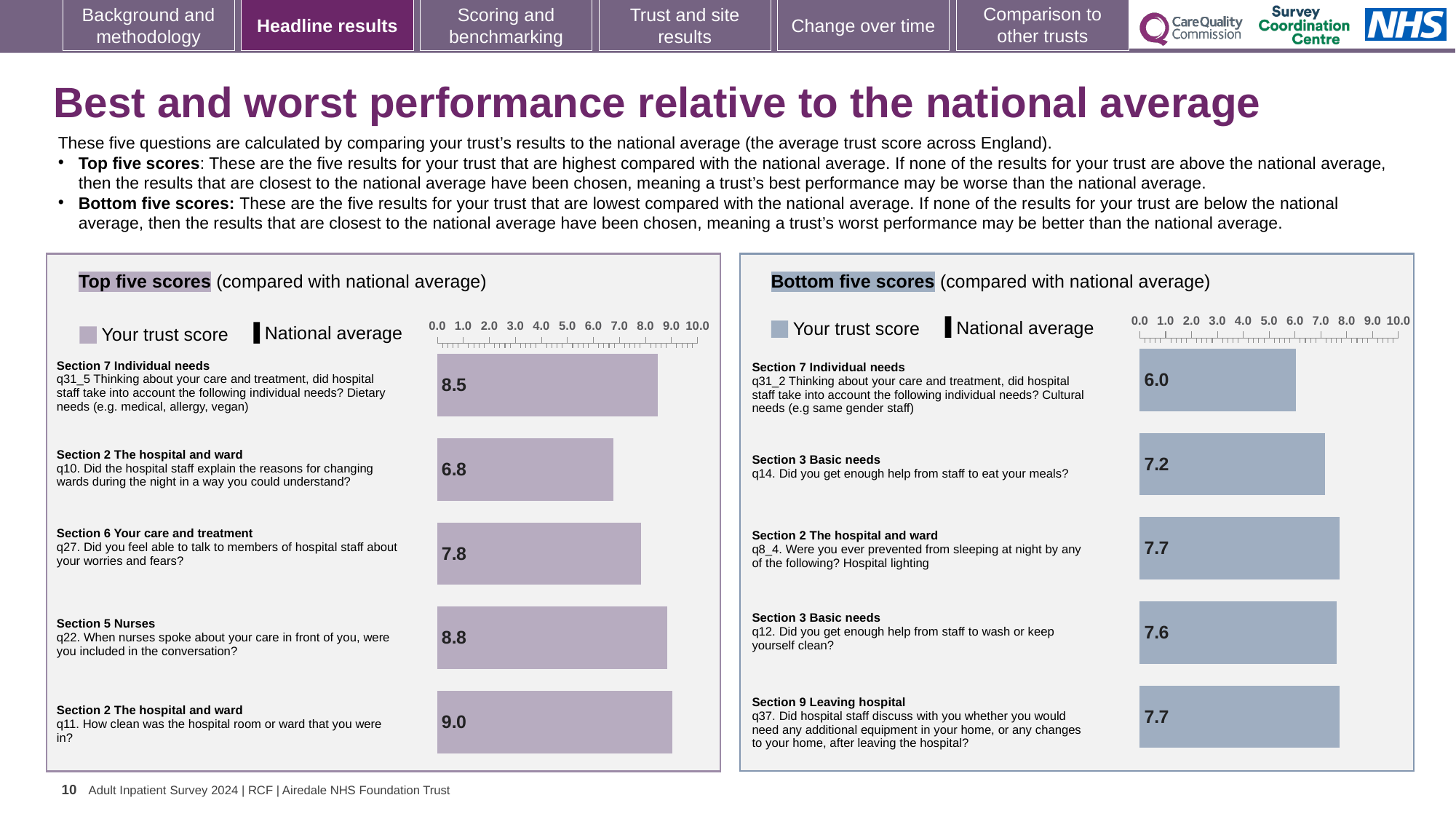
In the Top five scores chart, which question has the highest trust score? q11. How clean was the hospital room or ward that you were in? In the Bottom five scores chart, which question has the lowest trust score? q31_2 Cultural needs (e.g. same gender staff) In the Top five scores chart, which has the larger trust score: q31_5 (Dietary needs) or q10 (changing wards during the night)? q31_5 (Dietary needs) In the Top five scores chart, what is the trust score for q10 (Did the hospital staff explain the reasons for changing wards during the night)? 6.8 How many bars are shown in the Bottom five scores chart? 5 In the Bottom five scores chart, what is the trust score for q31_2 (Cultural needs, e.g. same gender staff)? 6.0 In the Bottom five scores chart, is the trust score for q12 (help to wash or keep yourself clean) greater or less than 7.0? greater In the Top five scores chart, what is the trust score for q11 (How clean was the hospital room or ward that you were in?)? 9.0 In the Bottom five scores chart, what is the difference between the trust scores for q8_4 and q31_2? 1.7 What type of chart is used in the Top five scores panel? Bar chart In the Bottom five scores chart, what is the trust score for q14 (Did you get enough help from staff to eat your meals?)? 7.2 In the Top five scores chart, what is the difference between the trust scores for q22 and q27? 1.0